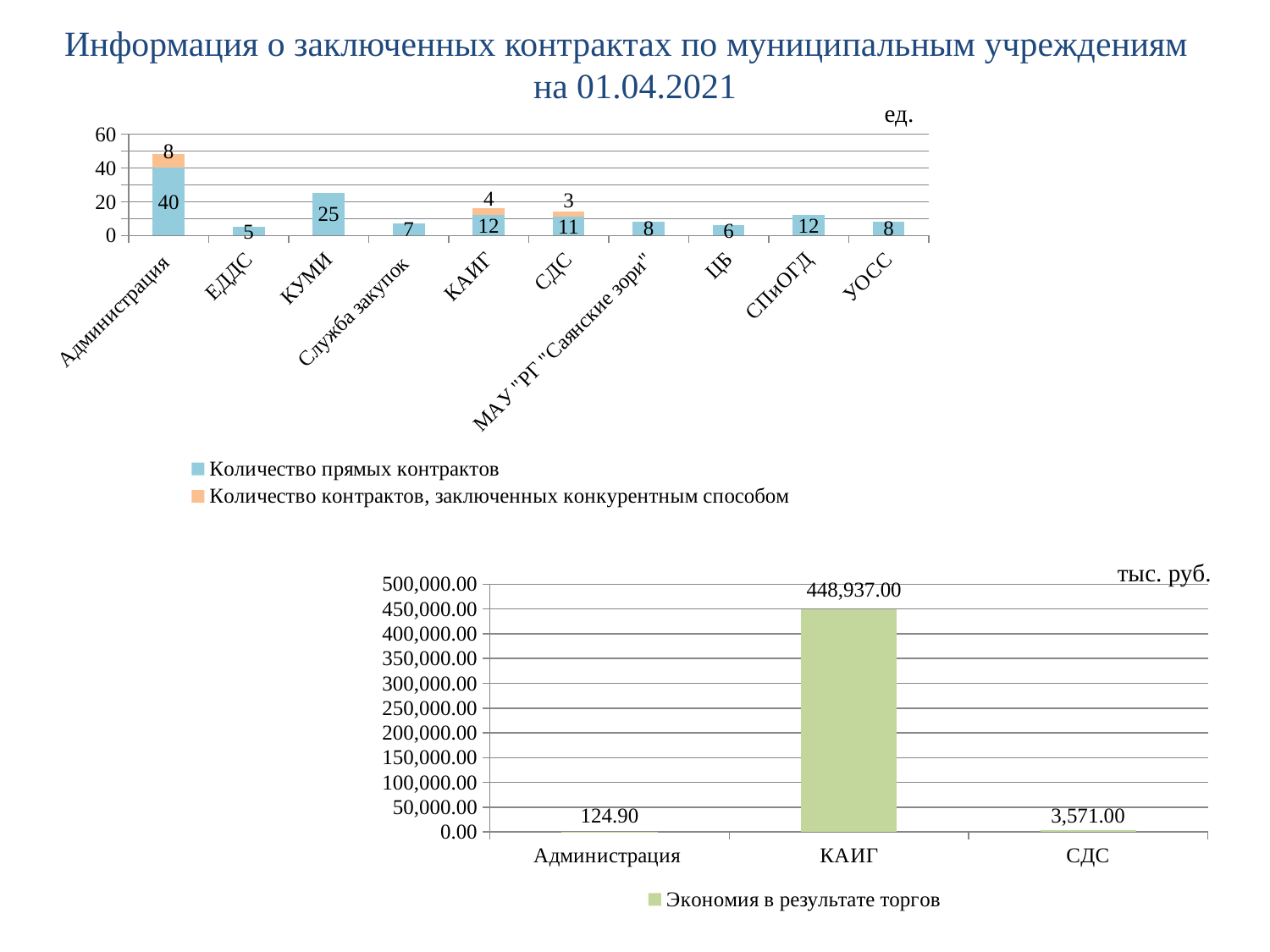
In the top chart, what is the total number of contracts for Администрация (both series combined)? 48 In the top chart, what is the difference between the direct contracts of КУМИ and ЦБ? 19 In the top chart, which category has the lowest number of direct contracts? ЕДДС What type of chart is the bottom chart? Bar chart In the bottom chart, what is the value for КАИГ? 448,937.00 In the bottom chart, which category has the lowest value? Администрация In the top chart, what is the total number of contracts for СДС (both series combined)? 14 In the top chart, how many categories are shown on the x axis? 10 In the top chart, how many series does the legend list? 2 In the top chart, how many contracts concluded by competitive method does КАИГ have? 4 In the top chart, how many direct contracts (Количество прямых контрактов) does Администрация have? 40 In the top chart, which category has the highest number of direct contracts? Администрация